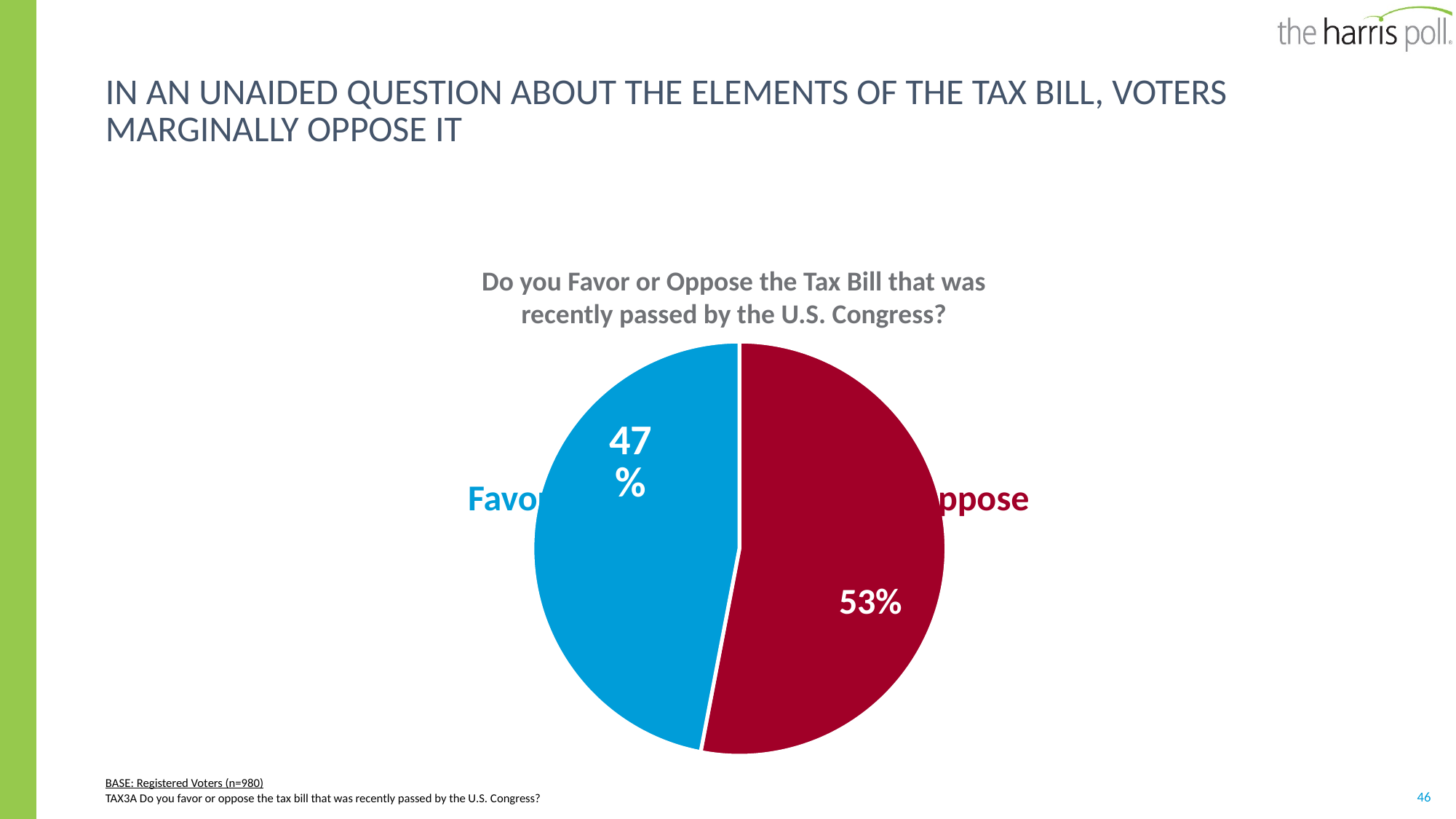
Which response has the larger share of the pie, Favor or Oppose? Oppose How many slices does the pie chart have? 2 By how many percentage points does Oppose exceed Favor? 6 What percentage of respondents favor the tax bill? 47% Is the share for Favor larger or smaller than the share for Oppose? smaller What kind of chart is shown on the slide? pie chart What colour is the Oppose slice? red Is the share for Oppose greater or less than 50%? greater What is the title of the chart? Do you Favor or Oppose the Tax Bill that was recently passed by the U.S. Congress? What is the combined share of the Favor and Oppose slices? 100% Which response has the smaller share of the pie? Favor What percentage of respondents oppose the tax bill? 53%